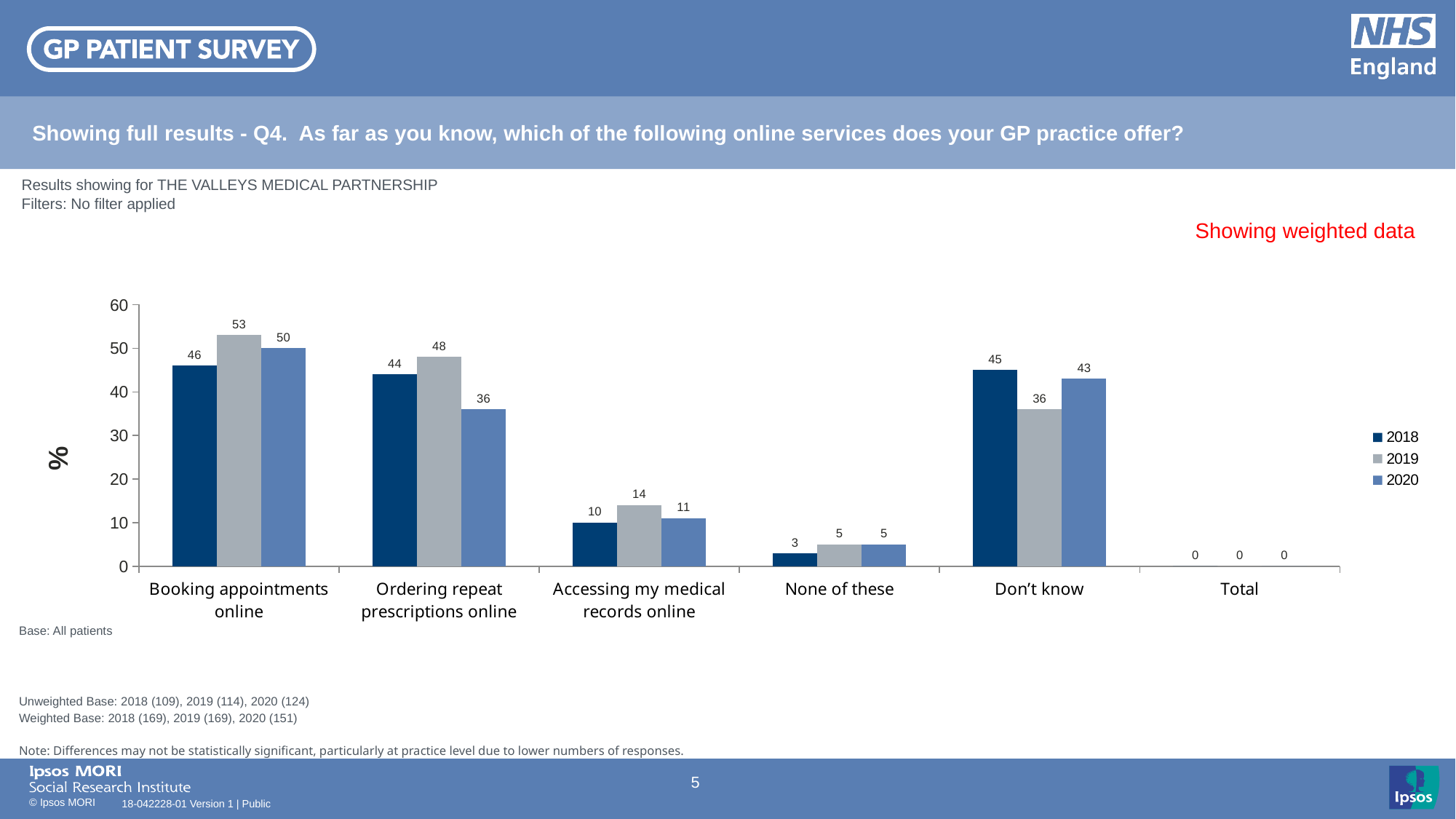
Which is larger for Don't know: the 2018 value or the 2019 value? 2018 What is the value for Booking appointments online in 2019? 53 How many categories are shown on the x axis? 6 What is the difference between the 2019 and 2020 values for Ordering repeat prescriptions online? 12 Which category has the highest value in the 2020 series? Booking appointments online Which category has the lowest value in the 2018 series? Total What is the value for Accessing my medical records online in 2019? 14 How many series does the legend list? 3 What is the value for Ordering repeat prescriptions online in 2020? 36 What kind of chart is shown on the slide? Bar chart What label is shown on the y axis? % What is the value for Don't know in 2018? 45